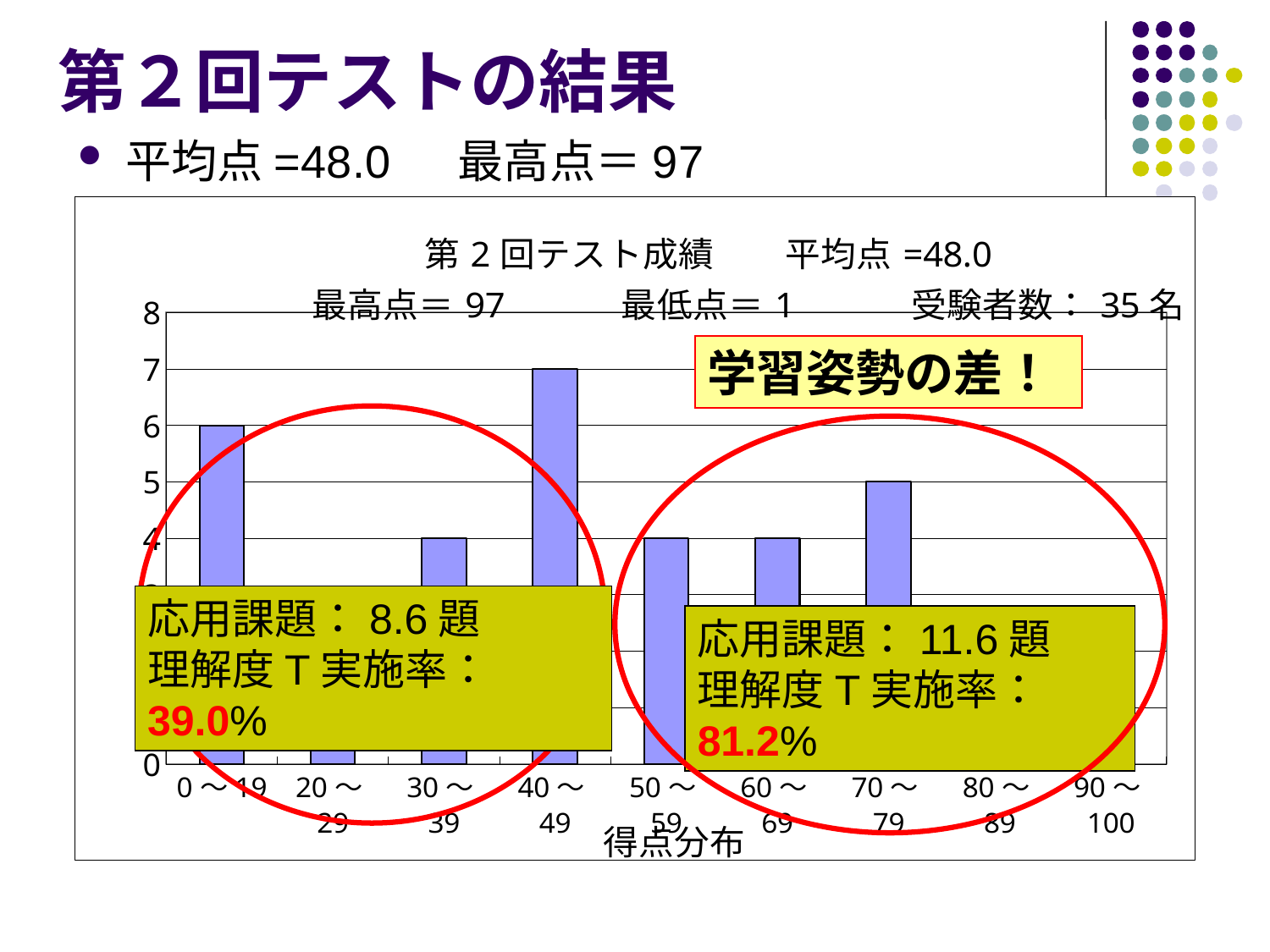
Is the value for the 20～29 range greater or less than 4? less How many score ranges are shown on the x axis? 9 What is the value for the 40～49 score range? 7 Which is larger, the value for 60～69 or the value for 70～79? 70～79 How many students scored in the 0～19 range? 6 What is the x-axis title of the chart? 得点分布 What is the value for the 70～79 score range? 5 What is the difference between the values for 40～49 and 0～19? 1 Which score range has the highest bar? 40～49 What kind of chart is shown on the slide? bar chart Which is larger, the value for 0～19 or the value for 70～79? 0～19 What is the value for the 30～39 score range? 4